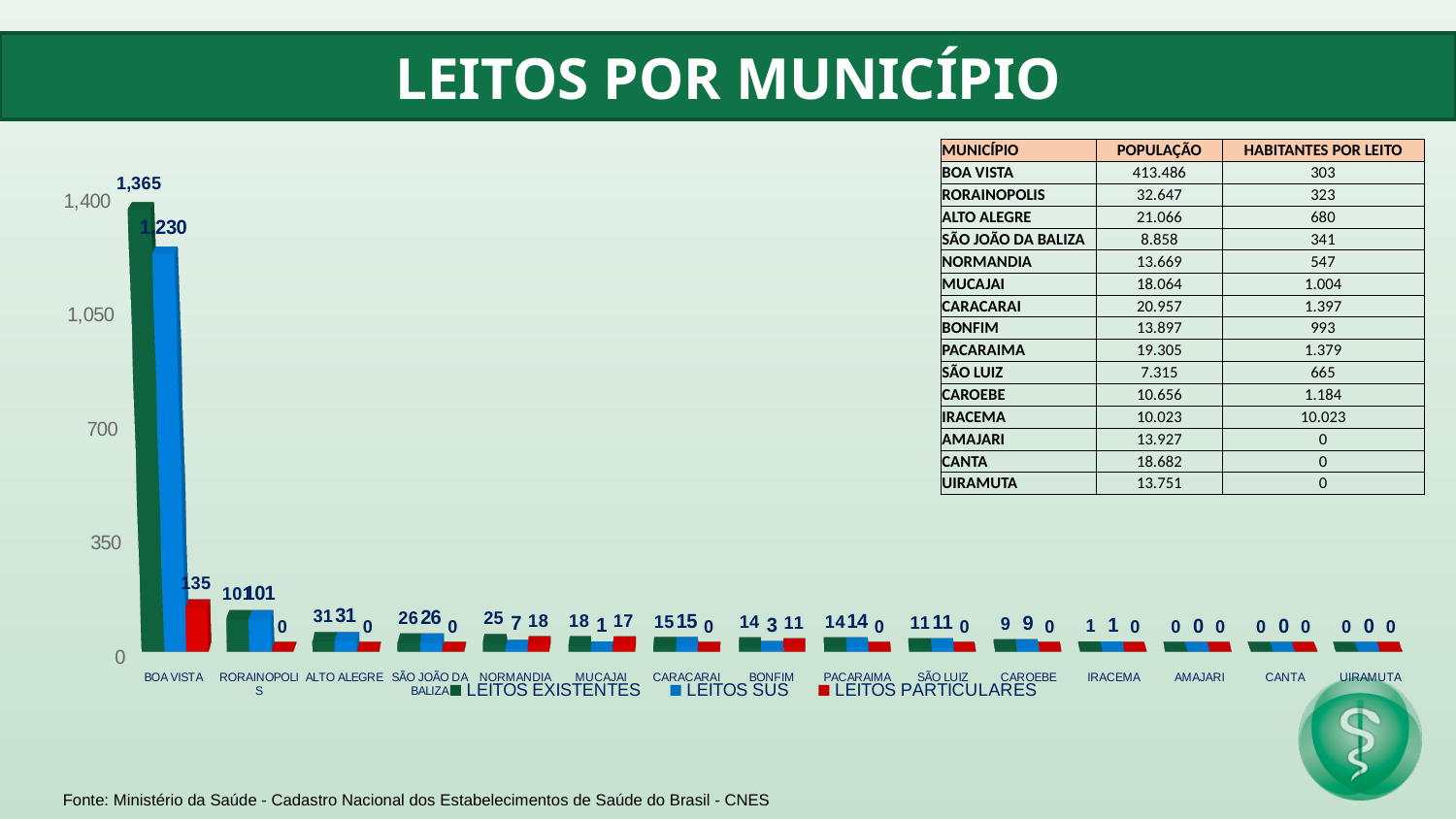
What is the difference between LEITOS EXISTENTES and LEITOS SUS for BOA VISTA? 135 How many municipalities are shown on the x axis of the chart? 15 Is the value of LEITOS SUS for BOA VISTA greater or less than 1,050? greater What is the title of the slide containing the chart? LEITOS POR MUNICÍPIO What is the value of LEITOS SUS for BOA VISTA? 1,230 What is the value of LEITOS PARTICULARES for NORMANDIA? 18 What type of chart is shown on the slide? bar chart What is the value of LEITOS EXISTENTES for BOA VISTA? 1,365 What is the value of LEITOS SUS for MUCAJAI? 1 Which is larger for BONFIM: LEITOS SUS or LEITOS PARTICULARES? LEITOS PARTICULARES Which municipality has the highest value for LEITOS EXISTENTES? BOA VISTA How many series does the chart legend list? 3